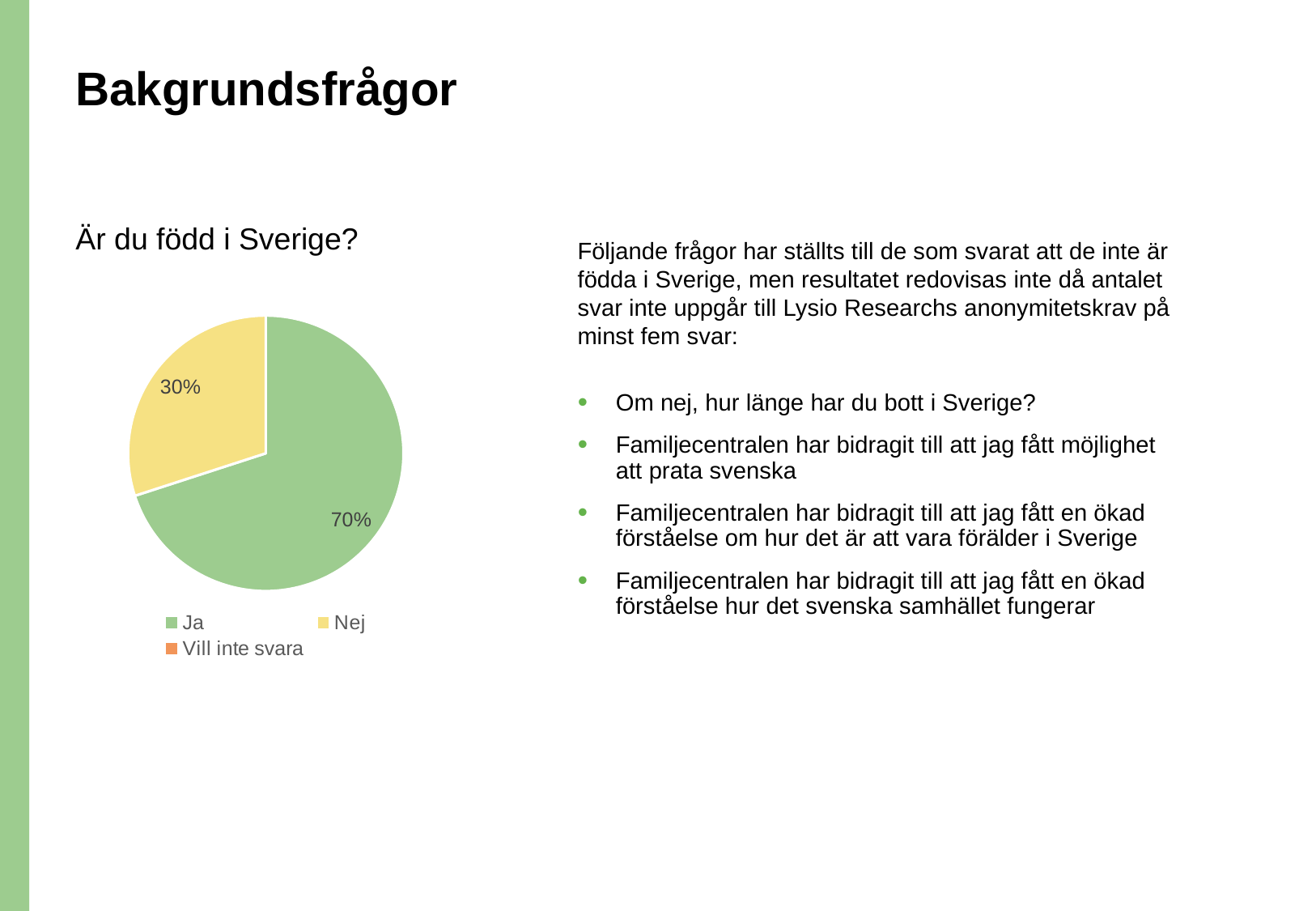
What colour is the "Ja" slice in the pie chart? Green How many entries does the legend of the pie chart list? 3 What share of respondents answered "Ja" to "Är du född i Sverige?"? 70% What share of respondents answered "Nej" to "Är du född i Sverige?"? 30% Which slice is larger, "Ja" or "Nej"? Ja What type of chart is shown on the slide? Pie chart Which of the visible slices in the pie chart is the smallest? Nej Is the share for "Ja" greater or less than 50%? greater Which answer has the largest slice in the pie chart? Ja What is the difference in percentage points between the "Ja" and "Nej" slices? 40 percentage points What is the title of the chart on the slide? Är du född i Sverige?